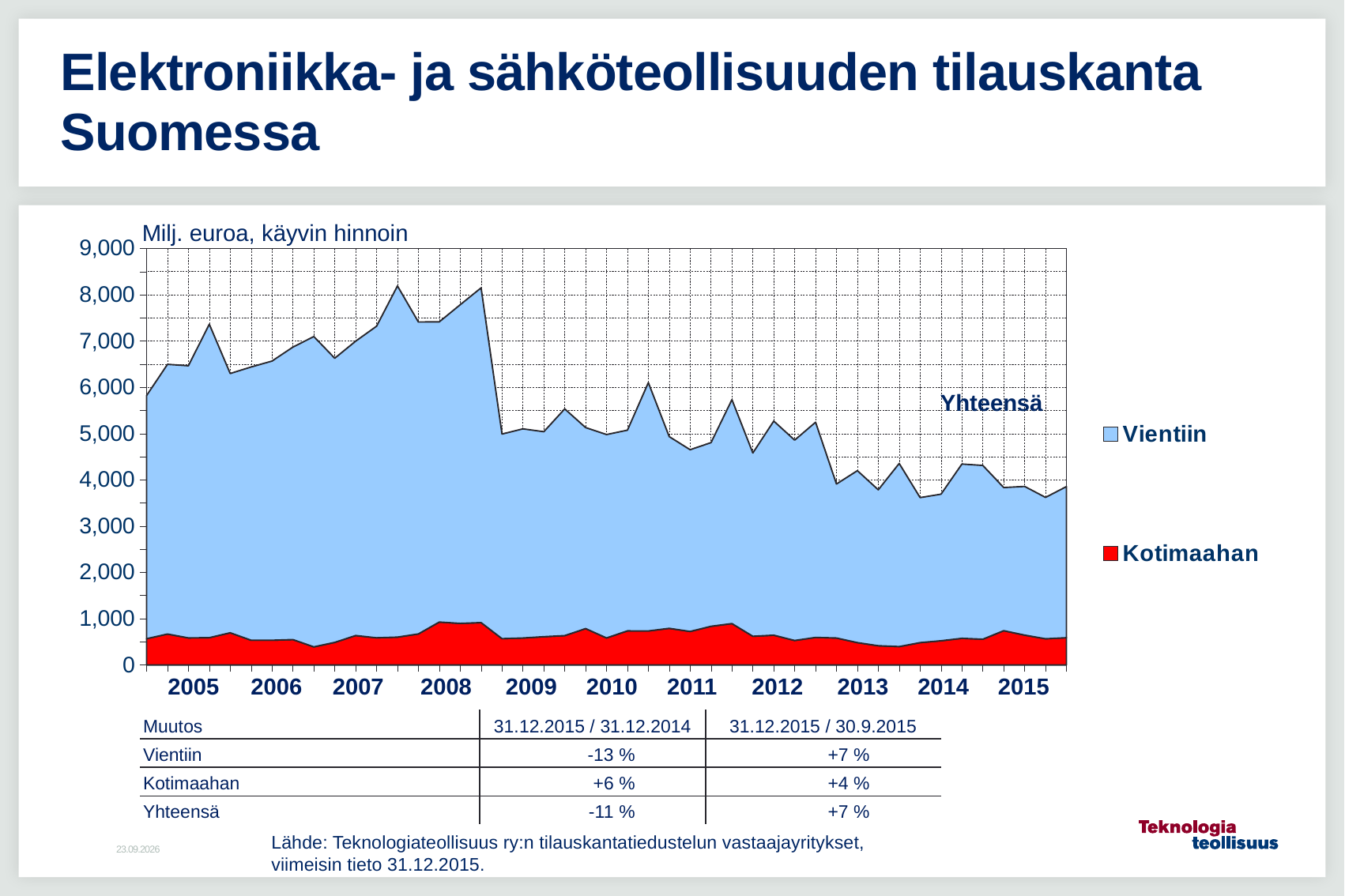
Which two series are listed in the chart legend? Vientiin and Kotimaahan Does the total order backlog rise or fall overall from 2005 to 2015? Fall Is the total (Yhteensä) value at the start of 2009 greater or less than 6,000? less According to the table below the chart, what is the change in Vientiin for 31.12.2015 / 31.12.2014? -13 % What kind of chart is shown on the slide? Area chart How many series does the legend list? 2 How many years are labelled on the x axis of the chart? 11 Is the total (Yhteensä) value at the start of 2005 greater or less than 5,000? greater Which is larger, the total order backlog in 2005 or in 2015? 2005 What unit is stated above the y axis of the chart? Milj. euroa, käyvin hinnoin Is the total (Yhteensä) value at the end of 2015 greater or less than 5,000? less